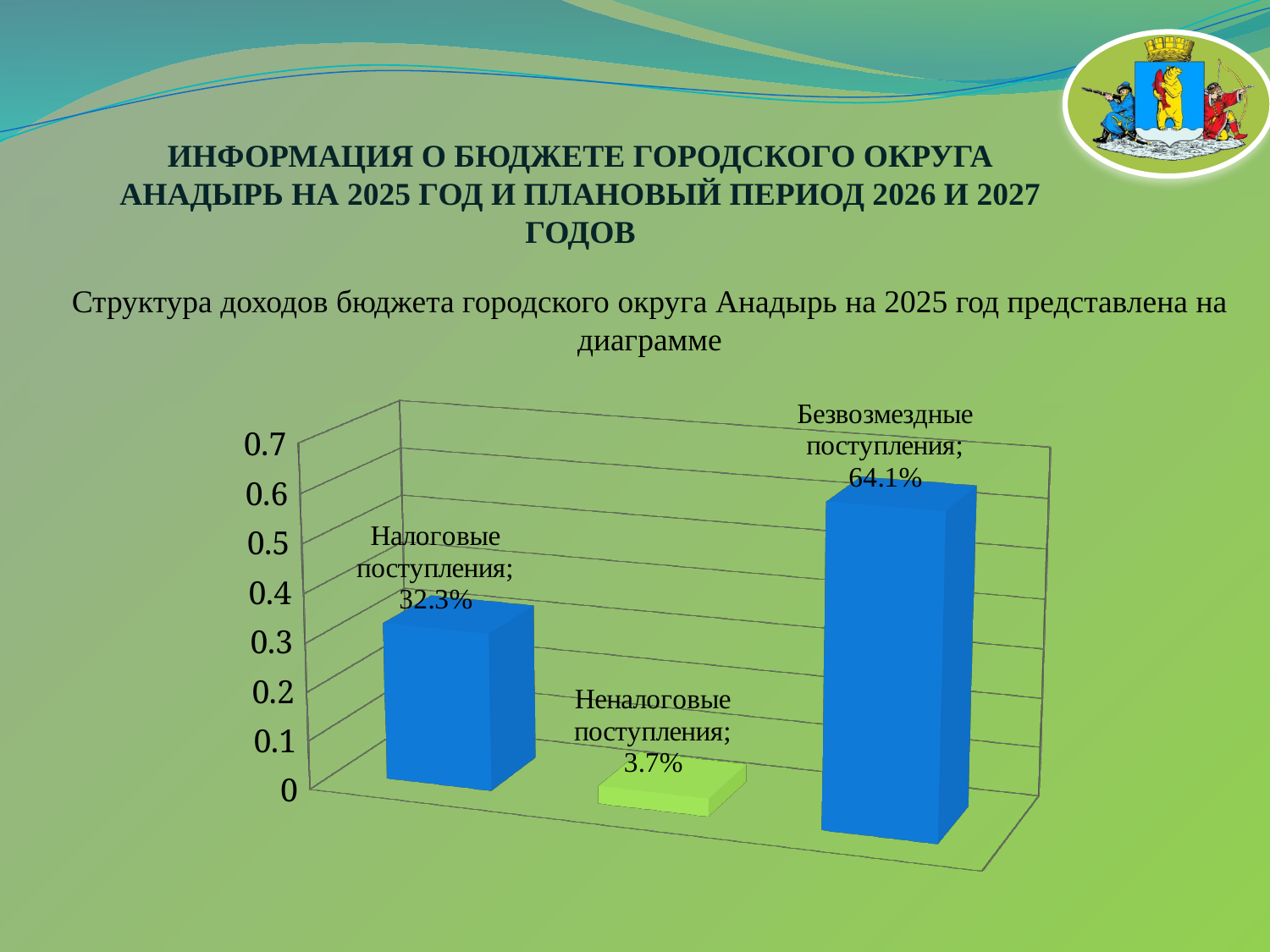
Is the value for Безвозмездные поступления greater or less than 0.5 on the axis? greater What is the value for Налоговые поступления? 32.3% Which category has the highest value? Безвозмездные поступления What kind of chart is shown on the slide? bar chart What is the value for Безвозмездные поступления? 64.1% Which category has the lowest value? Неналоговые поступления What is the difference between Налоговые поступления and Неналоговые поступления? 28.6% What is the difference between Безвозмездные поступления and Налоговые поступления? 31.8% Which is larger, Налоговые поступления or Неналоговые поступления? Налоговые поступления What is the value for Неналоговые поступления? 3.7% How many categories are shown in the chart? 3 What is the highest value shown on the vertical axis? 0.7